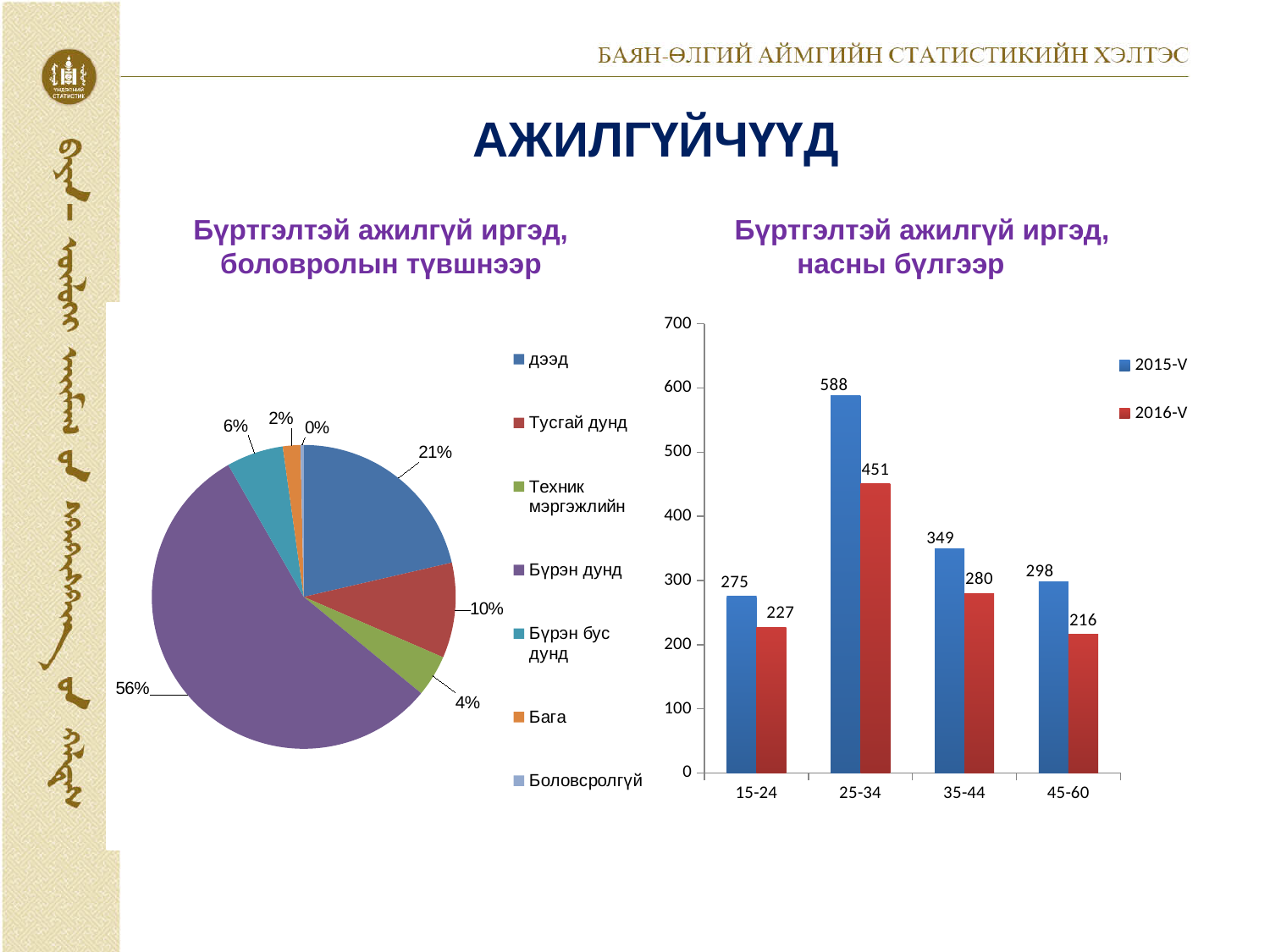
What kind of chart is the chart on the right of the slide? Bar chart In the bar chart on the right, which age group has the lowest 2015-V value? 15-24 In the bar chart on the right, which is larger for the 35-44 age group: the 2015-V value or the 2016-V value? 2015-V In the pie chart on the left, which category has the largest slice? Бүрэн дунд In the bar chart on the right, which age group has the highest 2016-V value? 25-34 In the bar chart on the right, how many series does the legend list? 2 In the pie chart on the left, what share is labelled for дээд? 21% In the pie chart on the left, what share is labelled for Бүрэн дунд? 56% In the bar chart on the right, what is the 2016-V value for the 45-60 age group? 216 In the bar chart on the right, what is the difference between the 2015-V and 2016-V values for the 25-34 age group? 137 In the pie chart on the left, how many categories does the legend list? 7 In the bar chart on the right, what is the 2015-V value for the 25-34 age group? 588